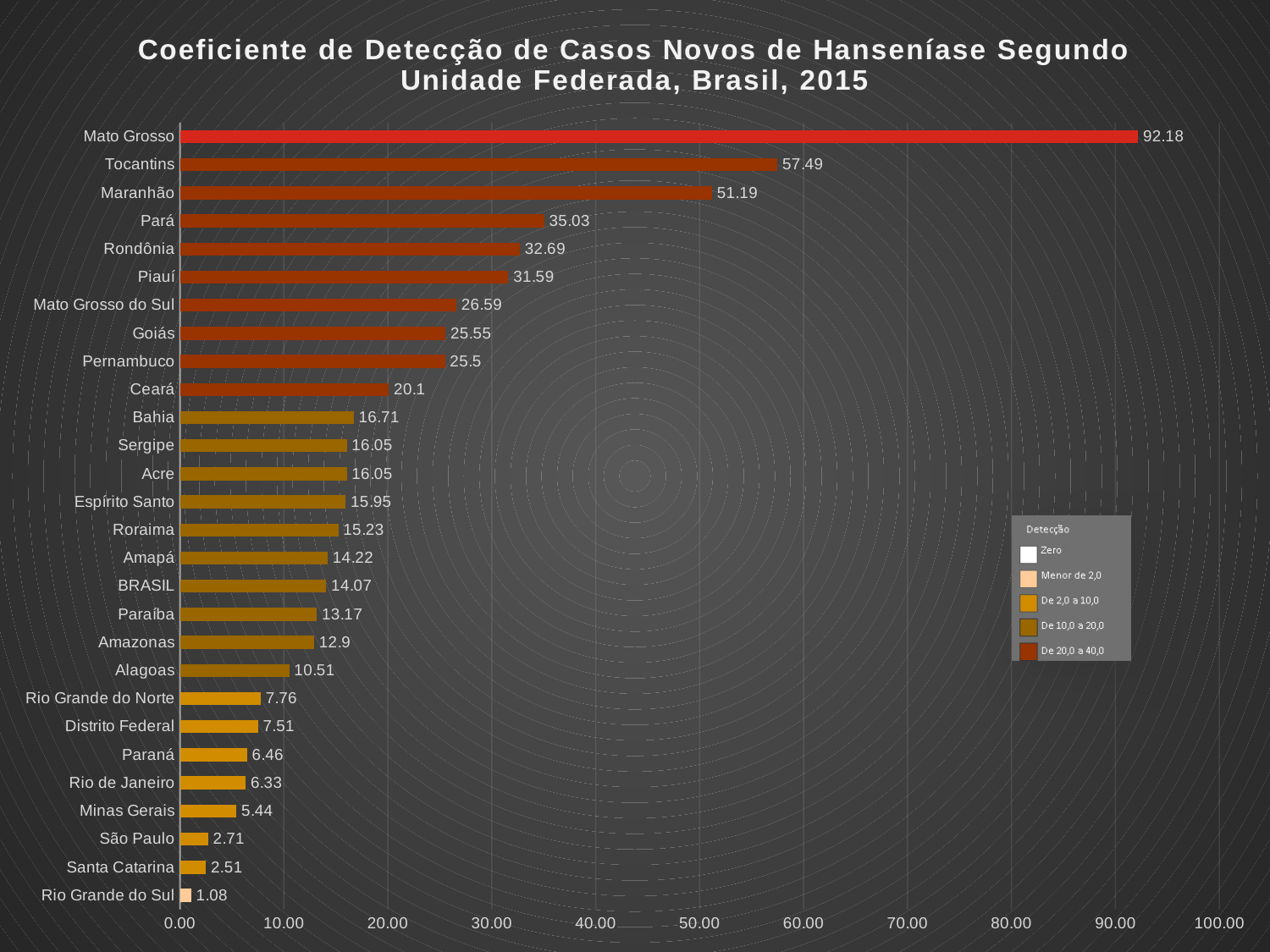
What kind of chart is shown on the slide? bar chart How many entries does the legend list? 5 Which unit has the highest detection coefficient? Mato Grosso Which unit has the lowest detection coefficient? Rio Grande do Sul How many bars are plotted in the chart? 28 Is the value for Ceará greater or less than 30.00? less Which is larger, the value for Pará or the value for Rondônia? Pará What is the value for Pernambuco? 25.5 What is the value for Mato Grosso? 92.18 What is the title of the legend box? Detecção What is the value for BRASIL? 14.07 What is the difference between the values for Tocantins and Maranhão? 6.3